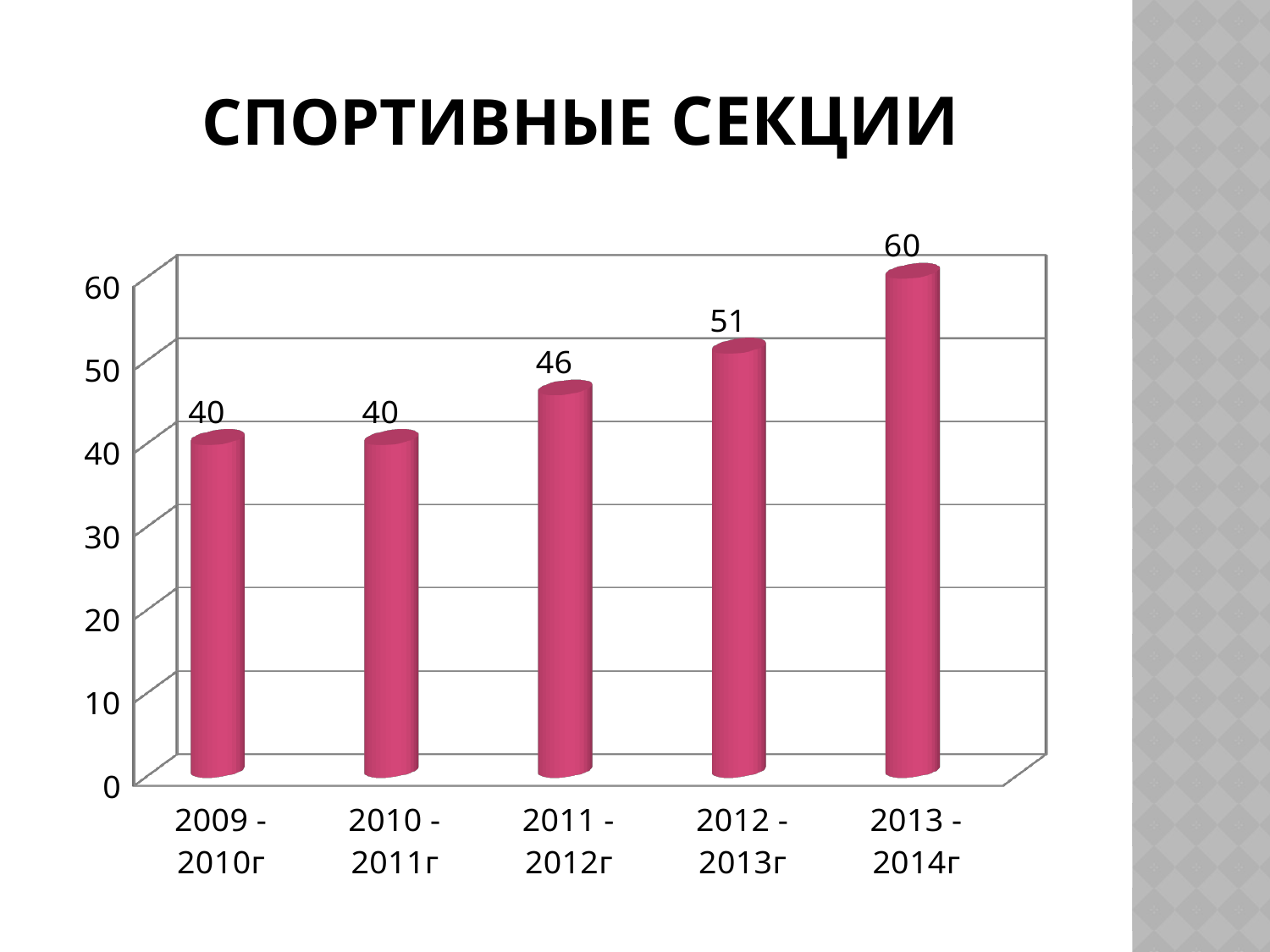
Is the value for 2012 - 2013г greater or less than 50? greater What is the value for 2011 - 2012г? 46 What is the title of the slide? СПОРТИВНЫЕ СЕКЦИИ What kind of chart is shown on the slide? bar chart Do the values rise or fall from 2009 - 2010г to 2013 - 2014г? rise What is the difference between the values for 2011 - 2012г and 2010 - 2011г? 6 Which is larger, the value for 2012 - 2013г or the value for 2011 - 2012г? 2012 - 2013г How many periods are shown on the chart? 5 What is the difference between the values for 2013 - 2014г and 2012 - 2013г? 9 Which period has the highest value? 2013 - 2014г What is the value for 2013 - 2014г? 60 What is the value for 2009 - 2010г? 40